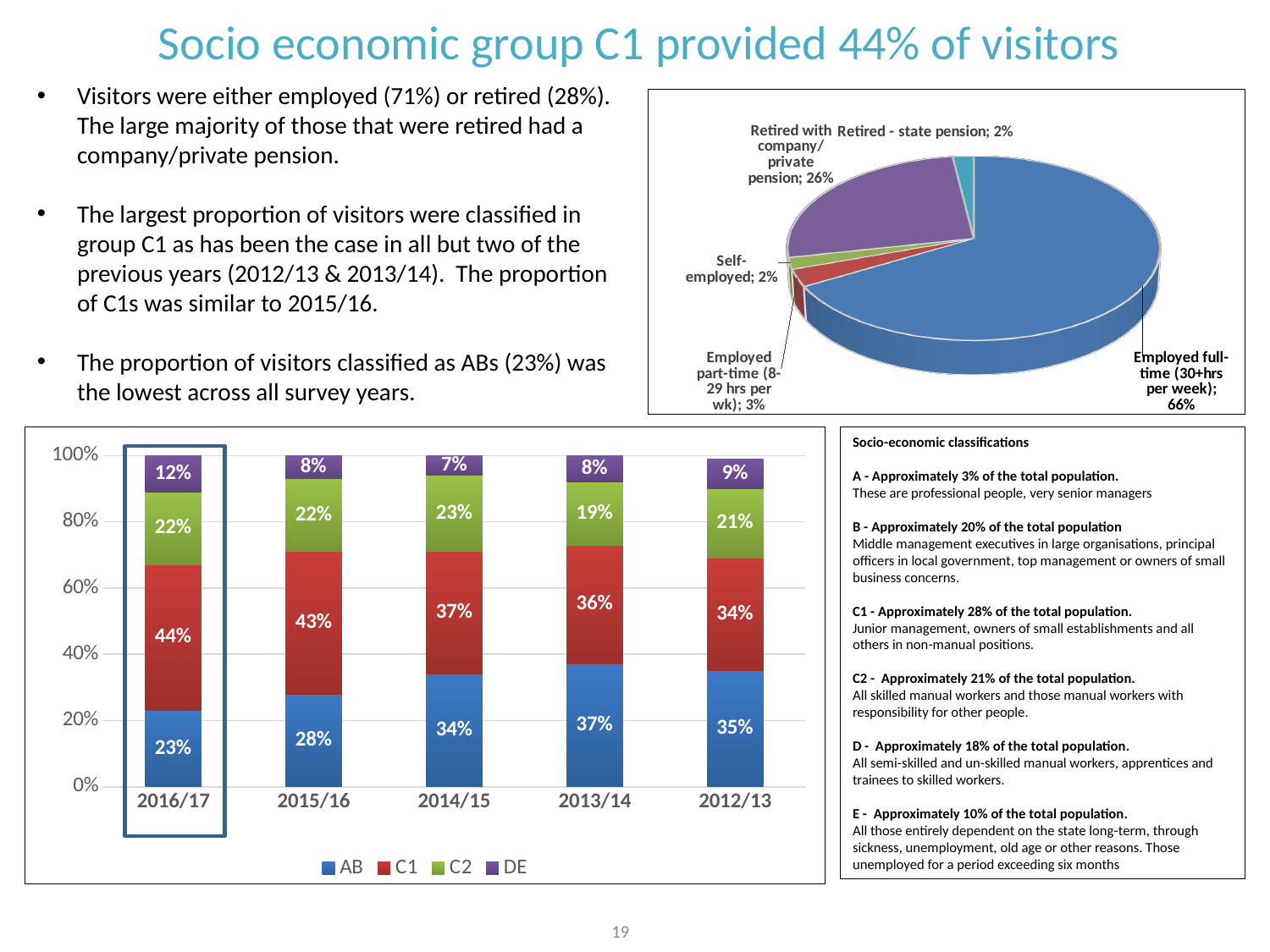
In the stacked bar chart, what is the value for AB in 2013/14? 37% In the stacked bar chart, which year has the lowest AB value? 2016/17 In the stacked bar chart, which year has the highest DE value? 2016/17 In the pie chart, which category has the largest slice? Employed full-time (30+hrs per week) In the stacked bar chart, is the C1 value larger in 2015/16 or in 2012/13? 2015/16 How many series does the legend of the stacked bar chart list? 4 How many slices does the pie chart have? 5 What type of chart is shown at the bottom left of the slide? Stacked bar chart In the pie chart, what is the difference between the share employed full-time and the share retired with a company/private pension? 40% In the pie chart, what share of visitors were employed full-time (30+hrs per week)? 66% In the pie chart, what share of visitors were retired with a company/private pension? 26% In the stacked bar chart, what is the value for C1 in 2016/17? 44%